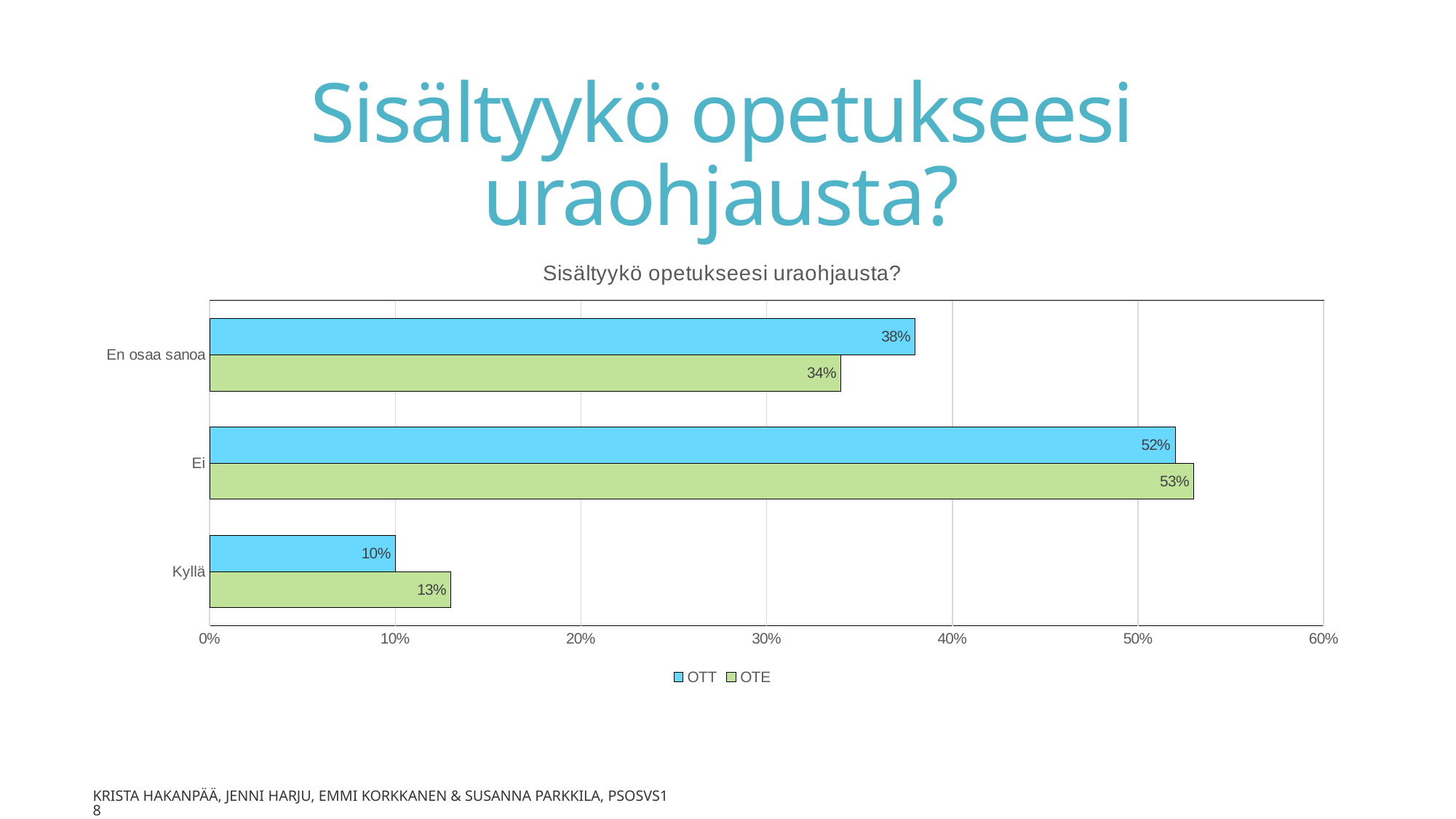
What is the OTE value for "Kyllä"? 13% What is the OTE value for "En osaa sanoa"? 34% What is the OTT value for "Ei"? 52% What is the difference between the OTT and OTE values for "En osaa sanoa"? 4% How many series does the legend list? 2 Which is larger for "Kyllä": the OTT value or the OTE value? OTE What kind of chart is shown on the slide? Bar chart Which category has the lowest OTT value? Kyllä How many categories are shown on the y axis? 3 Which category has the highest OTE value? Ei Is the OTT value for "Ei" greater or less than 50%? greater What is the title of the chart? Sisältyykö opetukseesi uraohjausta?